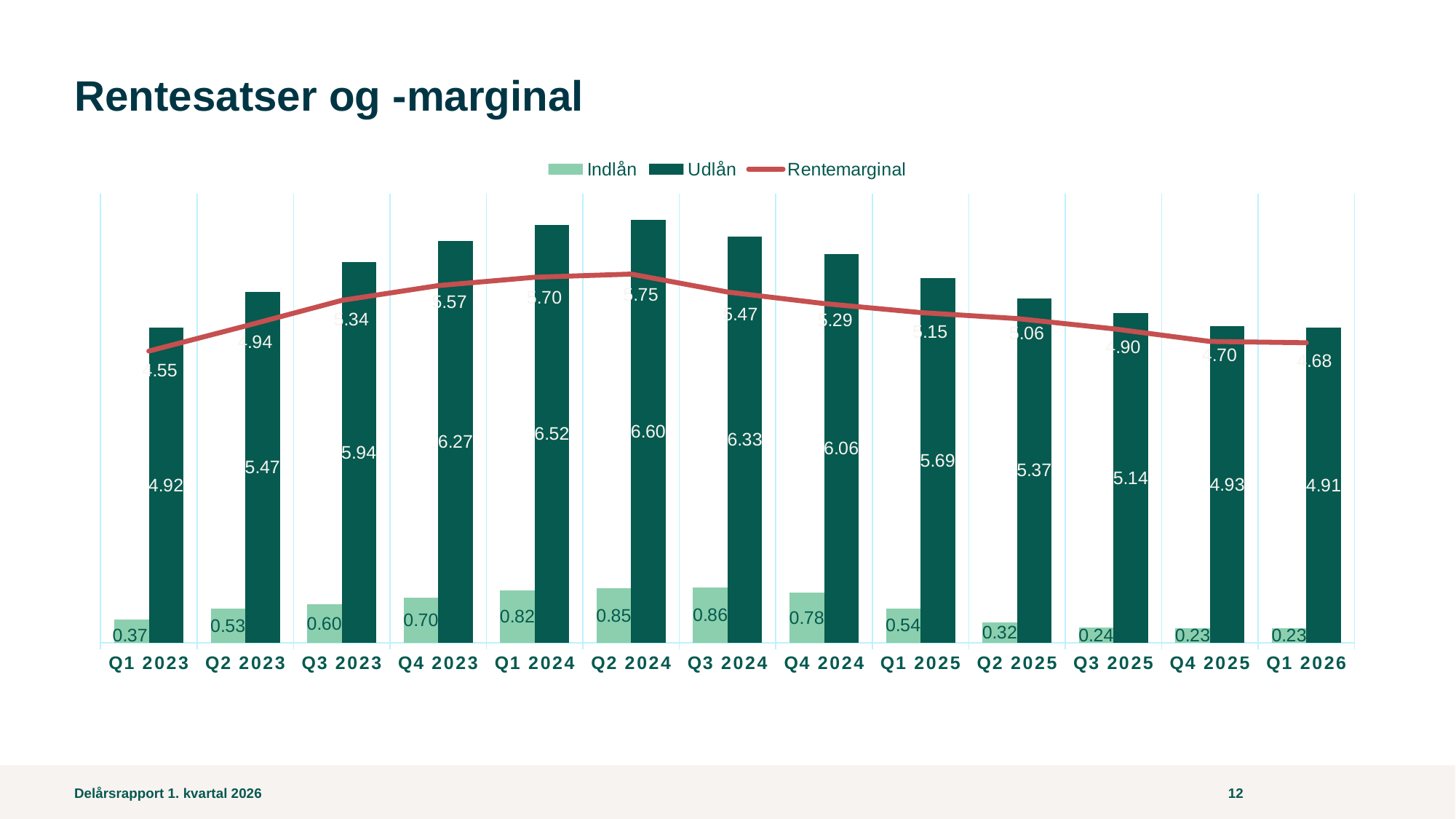
Which quarter has the lowest Udlån value? Q1 2026 What is the difference between the Udlån value and the Indlån value in Q1 2025? 5.15 What is the title of the chart? Rentesatser og -marginal How many quarters are shown on the x axis? 13 What is the Indlån value for Q4 2023? 0.70 How many series does the legend list? 3 Which quarter has the highest Indlån value? Q3 2024 What is the Rentemarginal value for Q1 2026? 4.68 Does the Udlån value rise or fall from Q2 2024 to Q1 2026? Fall What is the Udlån value for Q2 2024? 6.60 Which is larger, the Udlån value for Q3 2023 or the Udlån value for Q4 2024? Q4 2024 What kind of chart is this? Combined bar and line chart